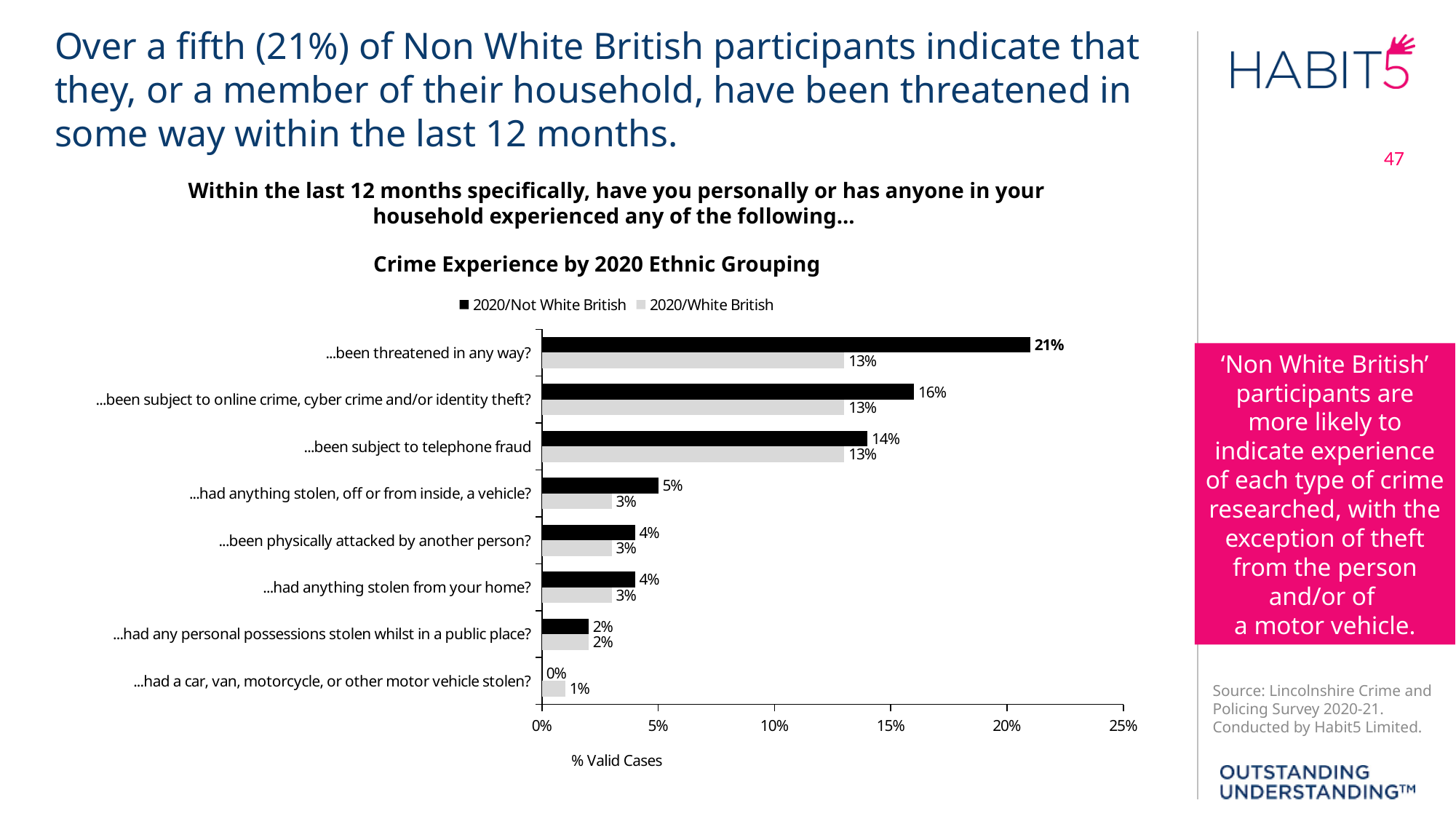
What is the value for 2020/White British for '...been subject to telephone fraud'? 13% What is the value for 2020/White British for '...had a car, van, motorcycle, or other motor vehicle stolen?' 1% Which category has the highest value for 2020/Not White British? ...been threatened in any way? What kind of chart is shown on the slide? Bar chart What is the value for 2020/Not White British for '...been threatened in any way?' 21% What is the difference between the 2020/Not White British and 2020/White British values for '...been threatened in any way?' 8% For '...been subject to online crime, cyber crime and/or identity theft?', which series has the larger value, 2020/Not White British or 2020/White British? 2020/Not White British What is the value for 2020/Not White British for '...had anything stolen, off or from inside, a vehicle?' 5% What is the title of the chart? Crime Experience by 2020 Ethnic Grouping How many categories are shown on the chart? 8 Which category has the lowest value for 2020/Not White British? ...had a car, van, motorcycle, or other motor vehicle stolen? How many series does the legend list? 2